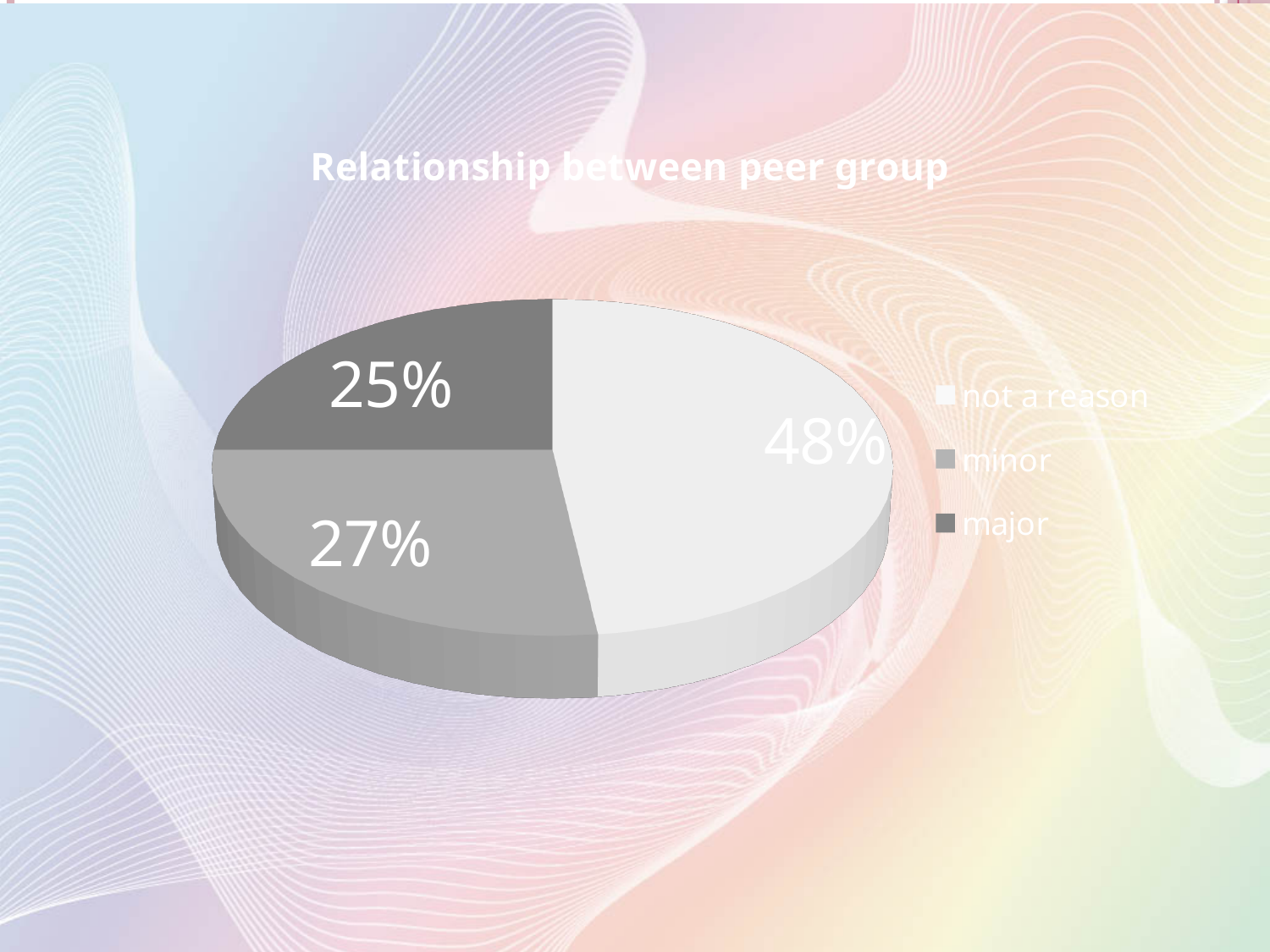
What share of the pie is labelled "minor"? 27% What share of the pie is labelled "major"? 25% What is the difference in percentage points between "not a reason" and "major"? 23 What kind of chart is shown on the slide? pie chart How many categories does the legend list? 3 Which category is shown in the darkest grey slice? major What share of the pie is labelled "not a reason"? 48% What is the title of the chart? Relationship between peer group What is the difference in percentage points between "minor" and "major"? 2 Which is larger, the share for "minor" or the share for "major"? minor Which category has the largest slice of the pie? not a reason Which category has the smallest slice of the pie? major